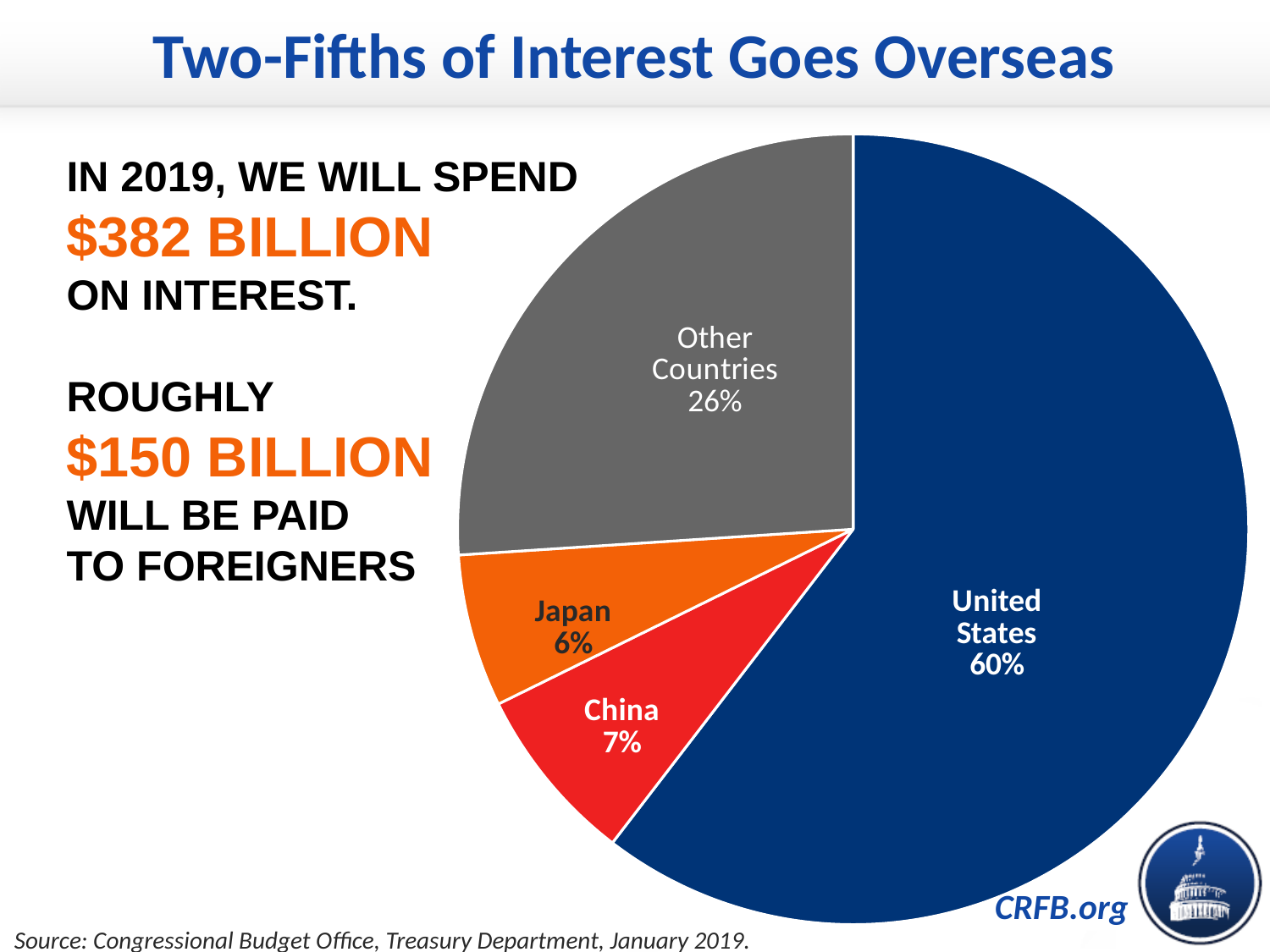
Which is larger, the China slice or the Japan slice? China What share of the pie does the Other Countries slice represent? 26% How many slices does the pie chart have? 4 Which slice of the pie is the smallest? Japan What share of the pie does the United States slice represent? 60% What is the difference in percentage points between the United States slice and the Other Countries slice? 34 percentage points What kind of chart is shown on the slide? Pie chart What share of the pie does the China slice represent? 7% What is the combined share of the China and Japan slices? 13% What colour is the United States slice? Dark blue Which slice of the pie is the largest? United States